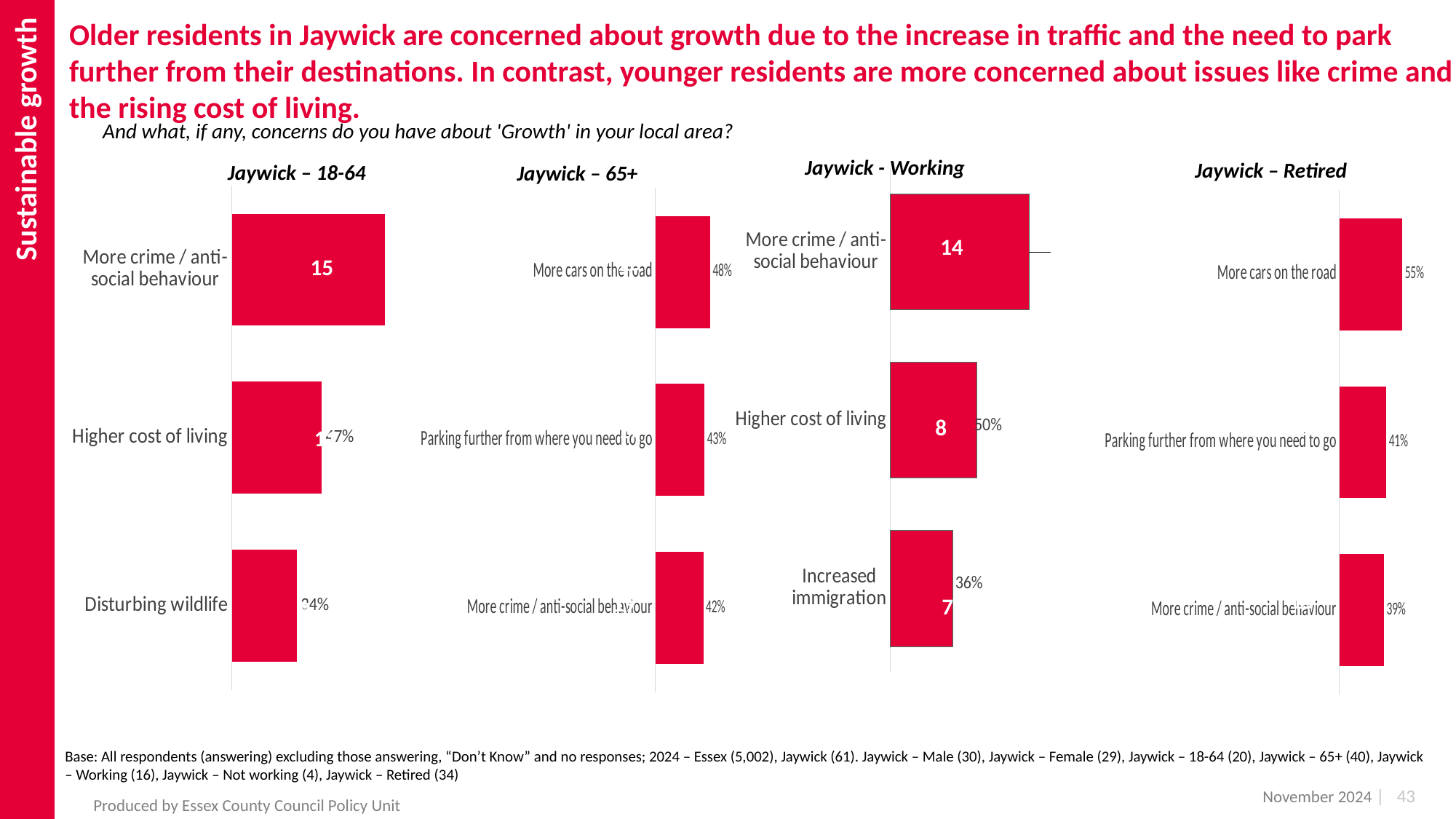
In the 'Jaywick – 65+' chart, what percentage is shown for 'More cars on the road'? 48% In the 'Jaywick – 18-64' chart, which concern has the longest bar? More crime / anti-social behaviour In the 'Jaywick – Retired' chart, which concern has the lowest value? More crime / anti-social behaviour In the 'Jaywick – Retired' chart, which is larger: 'Parking further from where you need to go' or 'More crime / anti-social behaviour'? Parking further from where you need to go What type of chart is the 'Jaywick – Retired' chart? Bar chart How many categories are shown in the 'Jaywick – 65+' chart? 3 In the 'Jaywick – Retired' chart, what is the difference between 'More cars on the road' and 'Parking further from where you need to go'? 14 percentage points In the 'Jaywick – 65+' chart, what is the difference between 'More cars on the road' and 'More crime / anti-social behaviour'? 6 percentage points In the 'Jaywick – 65+' chart, what percentage is shown for 'Parking further from where you need to go'? 43% In the 'Jaywick – Retired' chart, what percentage is shown for 'More cars on the road'? 55% In the 'Jaywick – Retired' chart, what percentage is shown for 'More crime / anti-social behaviour'? 39% In the 'Jaywick – 65+' chart, which concern has the highest value? More cars on the road